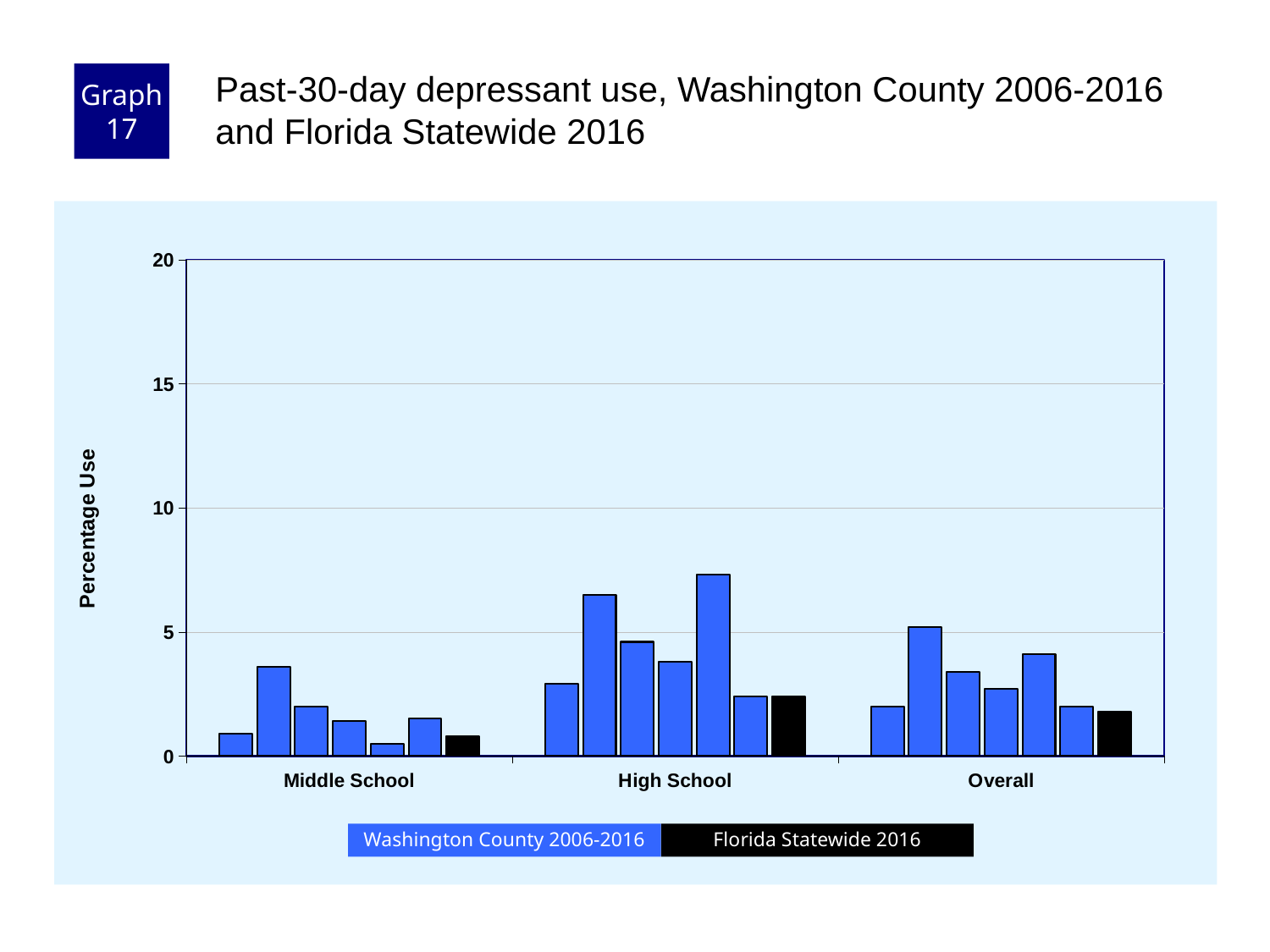
Is the tallest Washington County 2006-2016 bar for High School greater or less than 5? greater Which category contains the tallest bar in the chart? High School What is the label on the y axis? Percentage Use Is the Florida Statewide 2016 value for High School greater or less than 5? less Are all the Middle School bars greater or less than 5? less How many categories are shown along the x axis? 3 Which category has the lowest bars overall? Middle School Which is larger, the Florida Statewide 2016 value for High School or for Middle School? High School What kind of chart is shown on the slide? bar chart Which colour represents Florida Statewide 2016 in the legend? black How many series does the legend list? 2